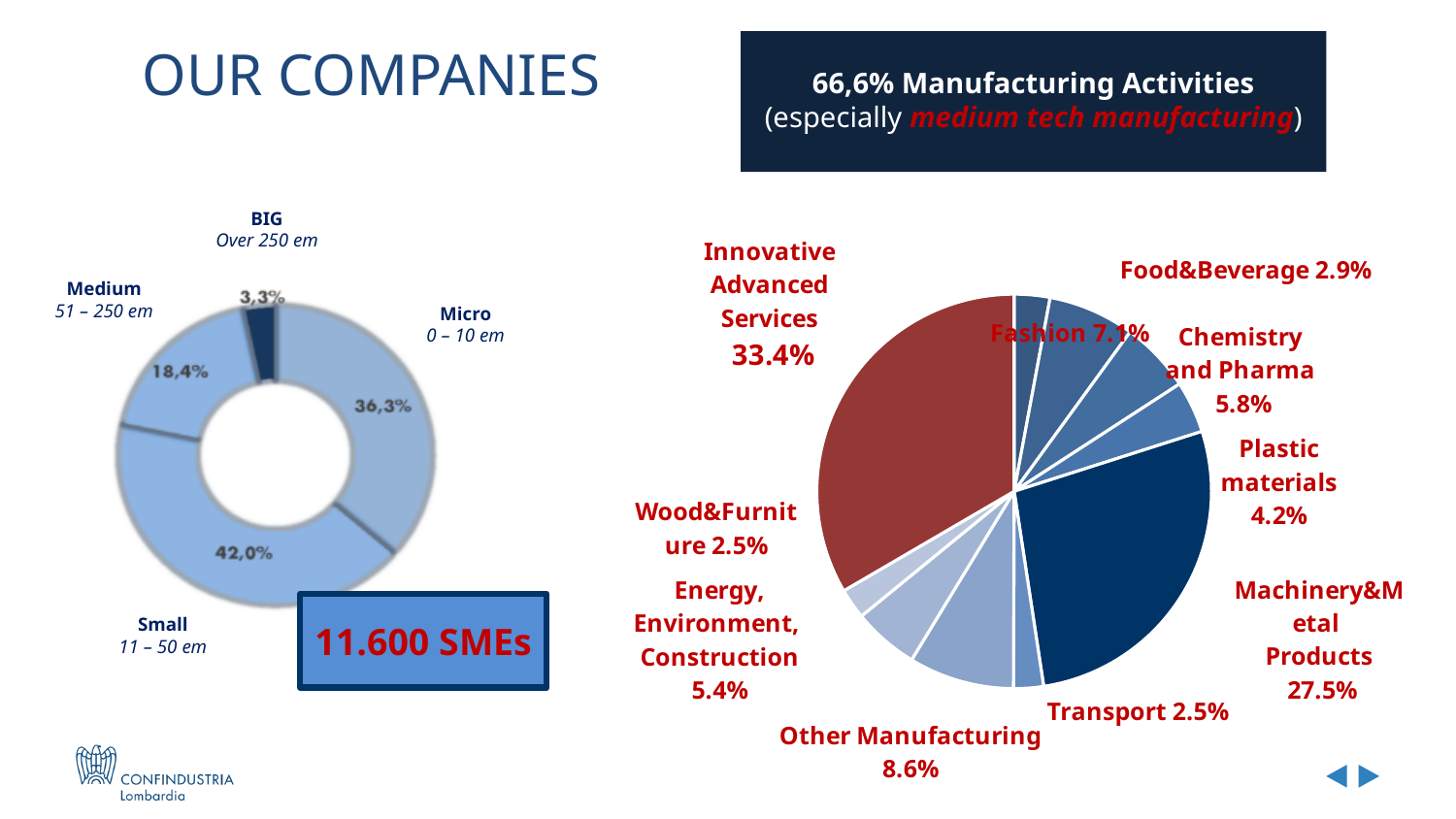
In the left donut chart of company sizes, what share do Medium companies represent? 18,4% In the left donut chart of company sizes, what share do Small companies represent? 42,0% In the left donut chart of company sizes, how many categories are shown? 4 In the right pie chart of sectors, how many sectors are shown? 10 In the right pie chart of sectors, what share does Other Manufacturing represent? 8.6% In the right pie chart of sectors, what share does Machinery&Metal Products represent? 27.5% In the right pie chart of sectors, which is larger, Fashion or Chemistry and Pharma? Fashion In the left donut chart of company sizes, which category has the largest share? Small What type of chart is used on the right side of the slide to show the sectors? Pie chart In the right pie chart of sectors, which sector has the largest share? Innovative Advanced Services In the left donut chart of company sizes, which category has the smallest share? BIG In the left donut chart of company sizes, what is the difference between the Micro share and the Medium share? 17,9%